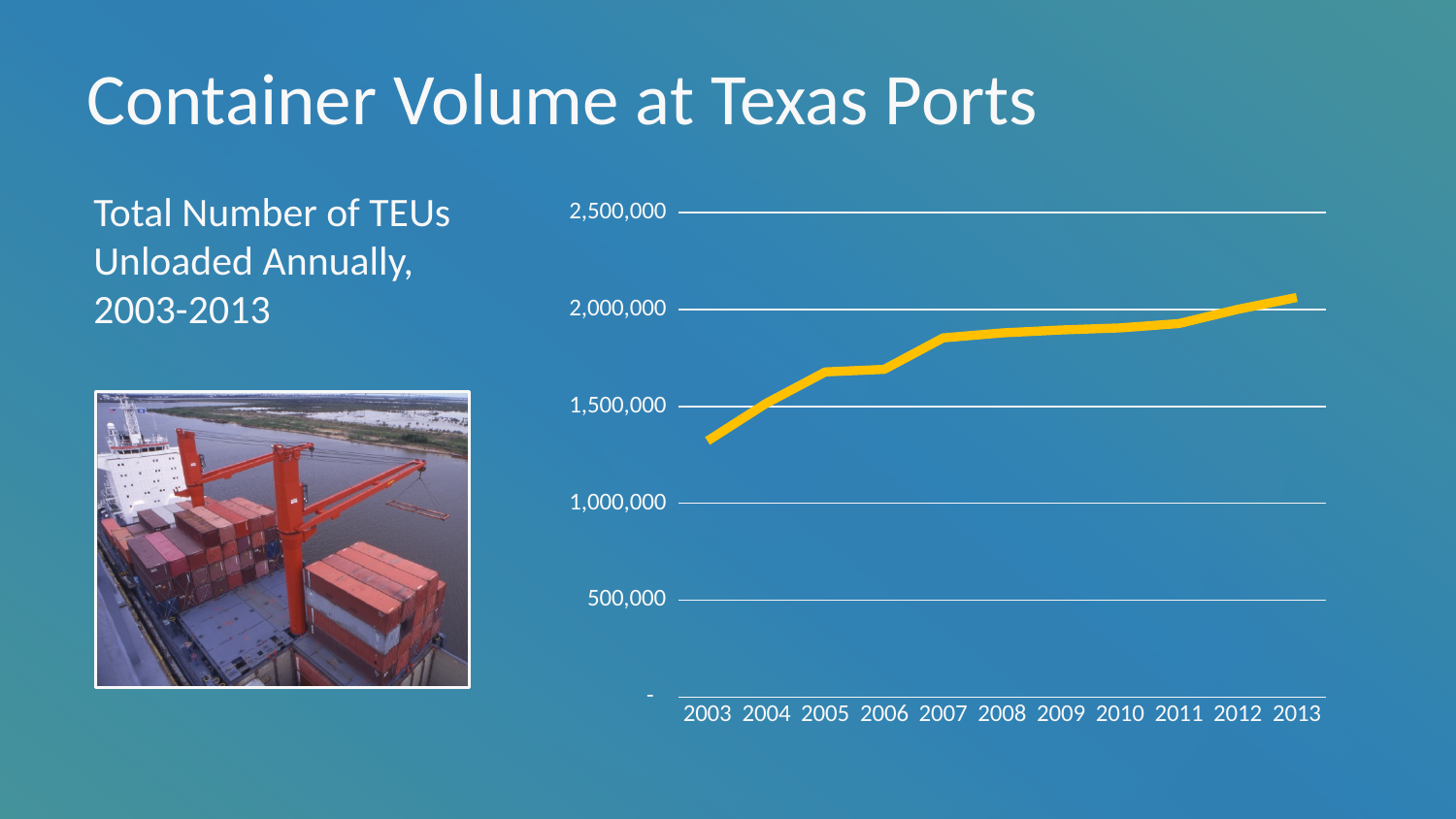
Do the values generally rise or fall from 2003 to 2013? rise How many years are plotted along the x axis of the chart? 11 Is the value for 2013 greater or less than 2,000,000? greater Which year has the larger value, 2005 or 2007? 2007 Is the value for 2009 greater or less than 2,000,000? less Is the value for 2003 greater or less than 1,500,000? less Which year has the lowest value on the chart? 2003 What is the highest tick value shown on the y axis? 2,500,000 What kind of chart is shown on the slide? line chart Which year has the highest value on the chart? 2013 What colour is the line plotted on the chart? yellow